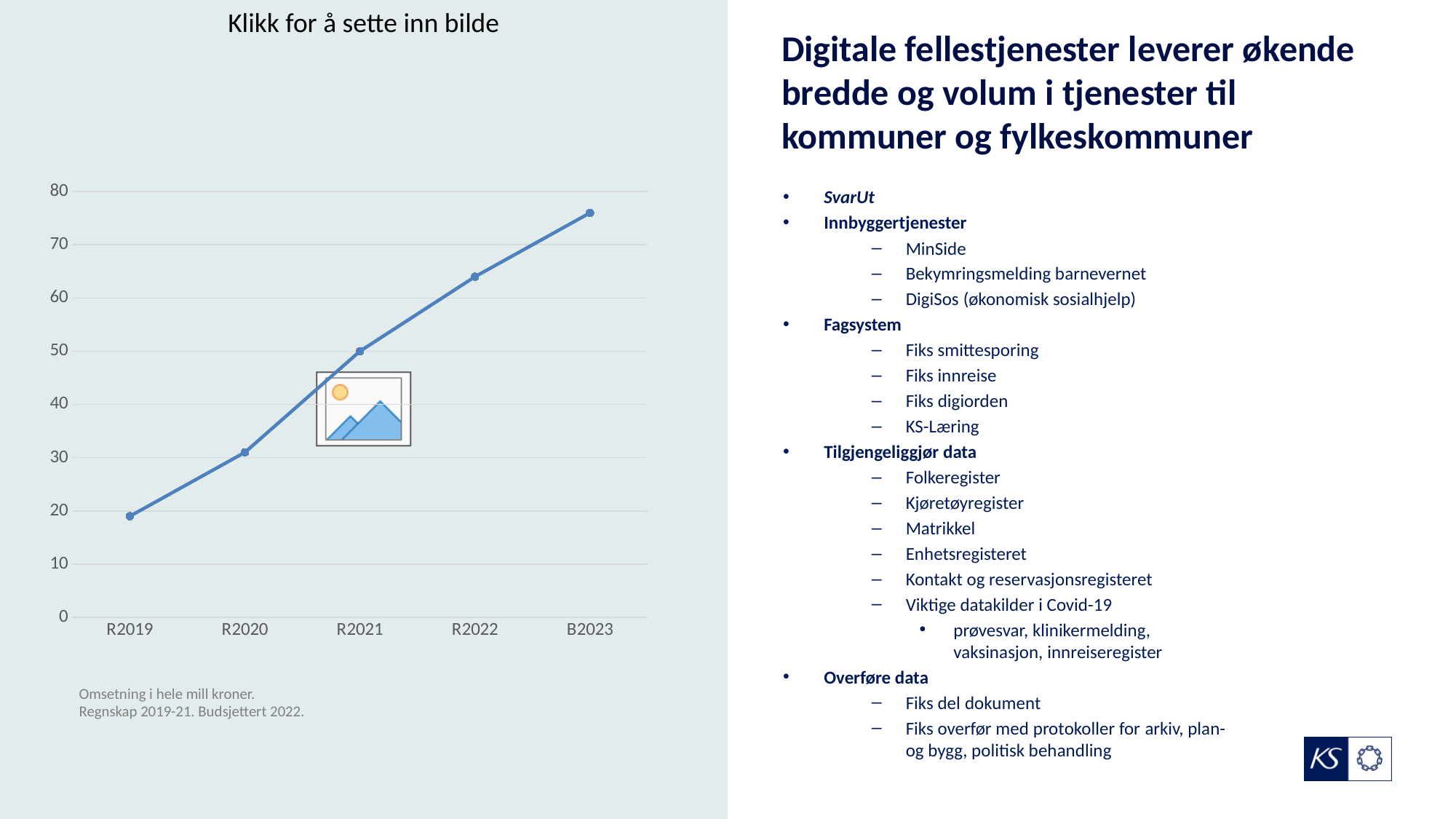
Which is larger, the value for R2020 or the value for R2022? R2022 What are the category labels along the x axis of the chart? R2019, R2020, R2021, R2022, B2023 What kind of chart is shown on the slide? line chart How many data points are plotted on the line chart? 5 Do the values rise or fall from R2019 to B2023? rise Is the value for R2022 greater or less than 60? greater Which category has the lowest value on the line chart? R2019 Is the value for B2023 greater or less than 80? less What is the value for R2021? 50 Which category has the highest value on the line chart? B2023